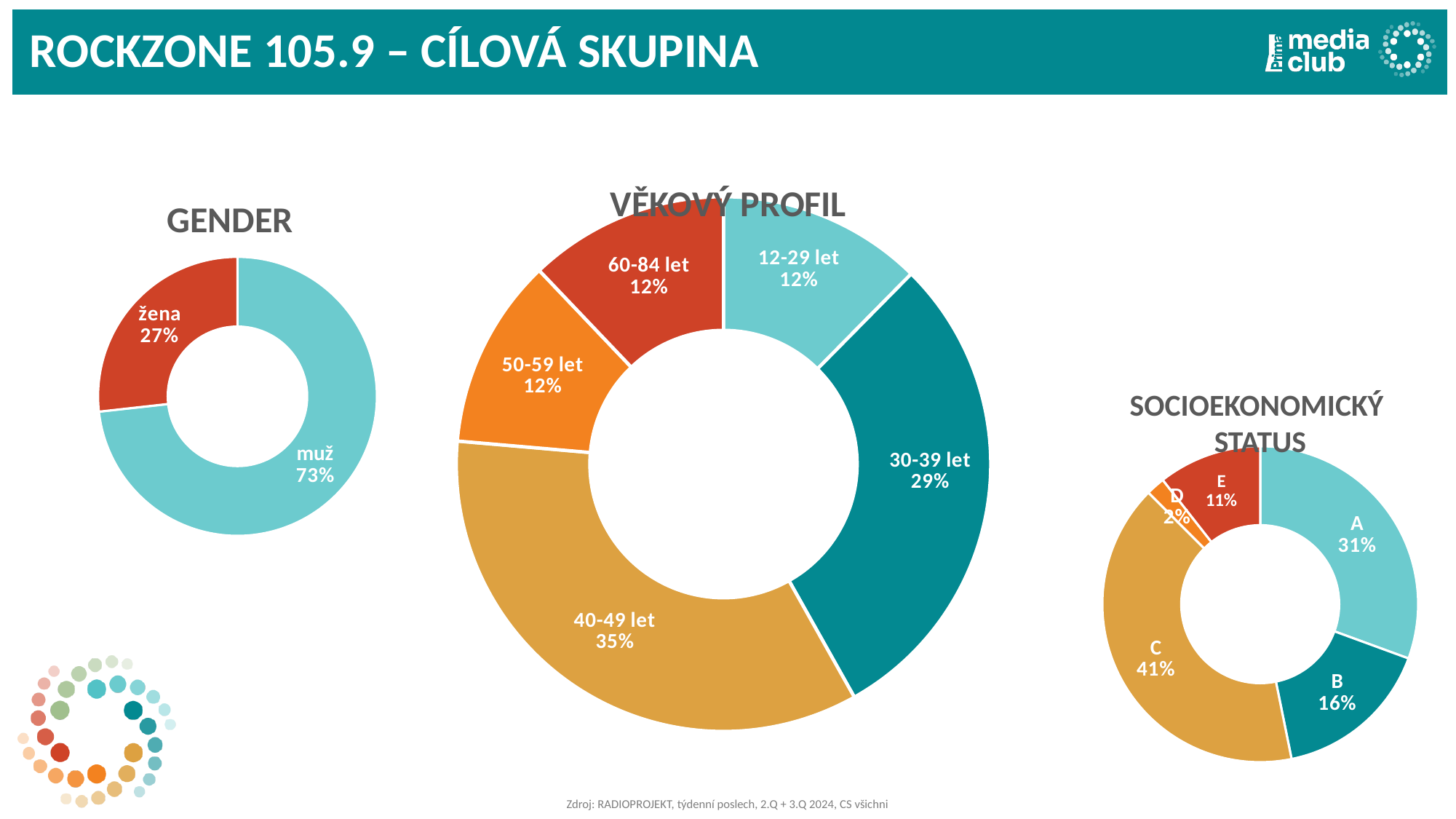
In the SOCIOEKONOMICKÝ STATUS chart, what is the difference in percentage points between C and E? 30 In the VĚKOVÝ PROFIL chart, what is the difference in percentage points between 40-49 let and 30-39 let? 6 How many charts are shown on the slide? 3 In the SOCIOEKONOMICKÝ STATUS chart, which category has the smallest share? D What type of chart is the GENDER chart? Donut chart In the VĚKOVÝ PROFIL chart, how many age groups are shown? 5 In the GENDER chart, what share is labelled for muž? 73% In the SOCIOEKONOMICKÝ STATUS chart, which is larger, A or B? A In the SOCIOEKONOMICKÝ STATUS chart, what share is shown for category C? 41% In the VĚKOVÝ PROFIL chart, which age group has the largest share? 40-49 let In the VĚKOVÝ PROFIL chart, what share is shown for 30-39 let? 29% In the GENDER chart, what share is labelled for žena? 27%